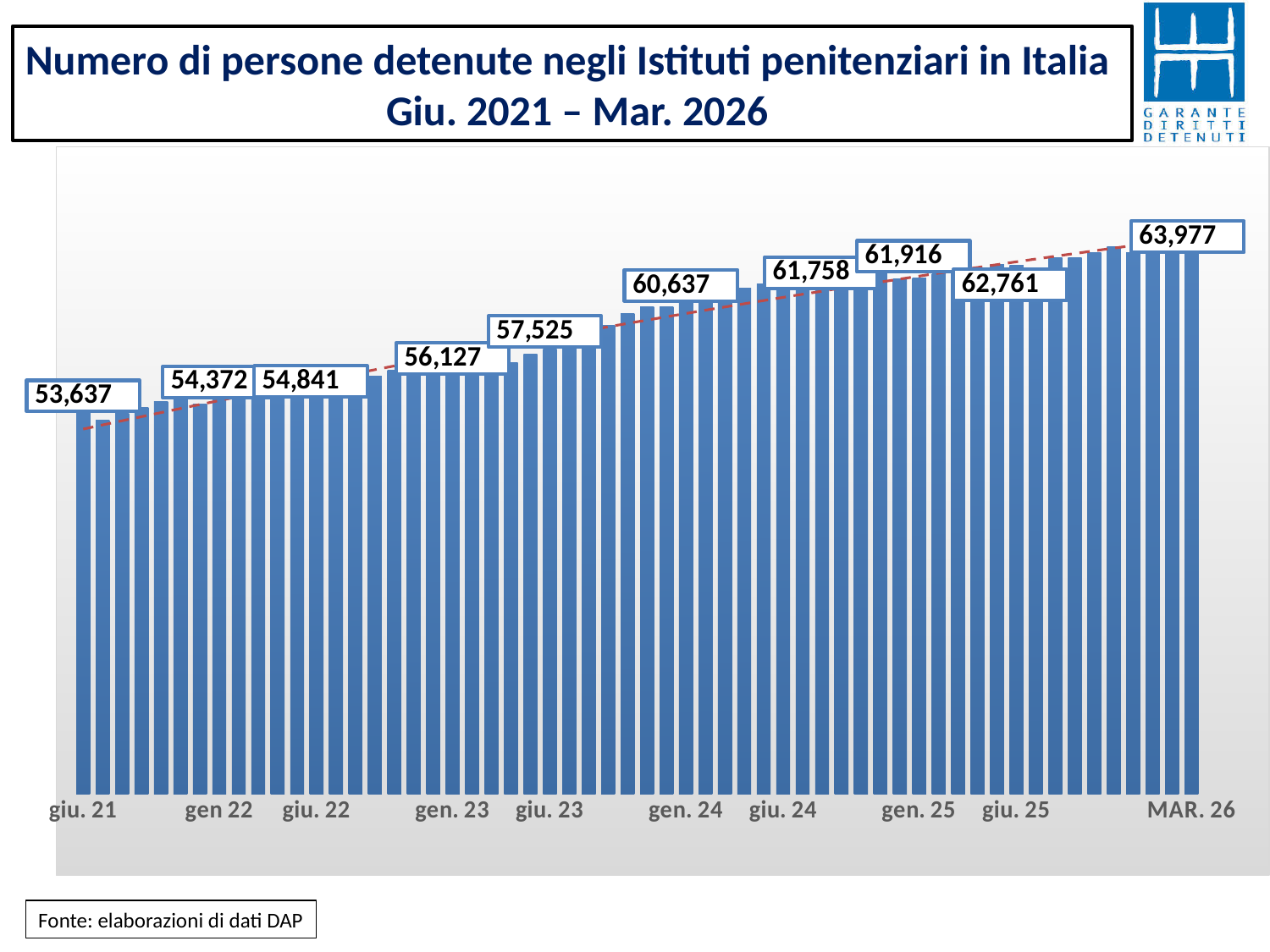
Which labelled period has the lowest value? giu. 21 What is the number of detained persons shown for giu. 21? 53,637 What type of chart is shown on the slide? bar chart Which labelled period has the highest value? MAR. 26 What value is labelled for gen. 24? 60,637 What is the difference between the value for MAR. 26 and the value for giu. 21? 10,340 What value is labelled for MAR. 26? 63,977 What is the difference between the labelled values for gen. 24 and giu. 23? 3,112 What is the title of the chart? Numero di persone detenute negli Istituti penitenziari in Italia Giu. 2021 – Mar. 2026 Which is larger, the labelled value for gen 22 or for giu. 22? giu. 22 Do the values generally rise or fall from giu. 21 to MAR. 26? rise